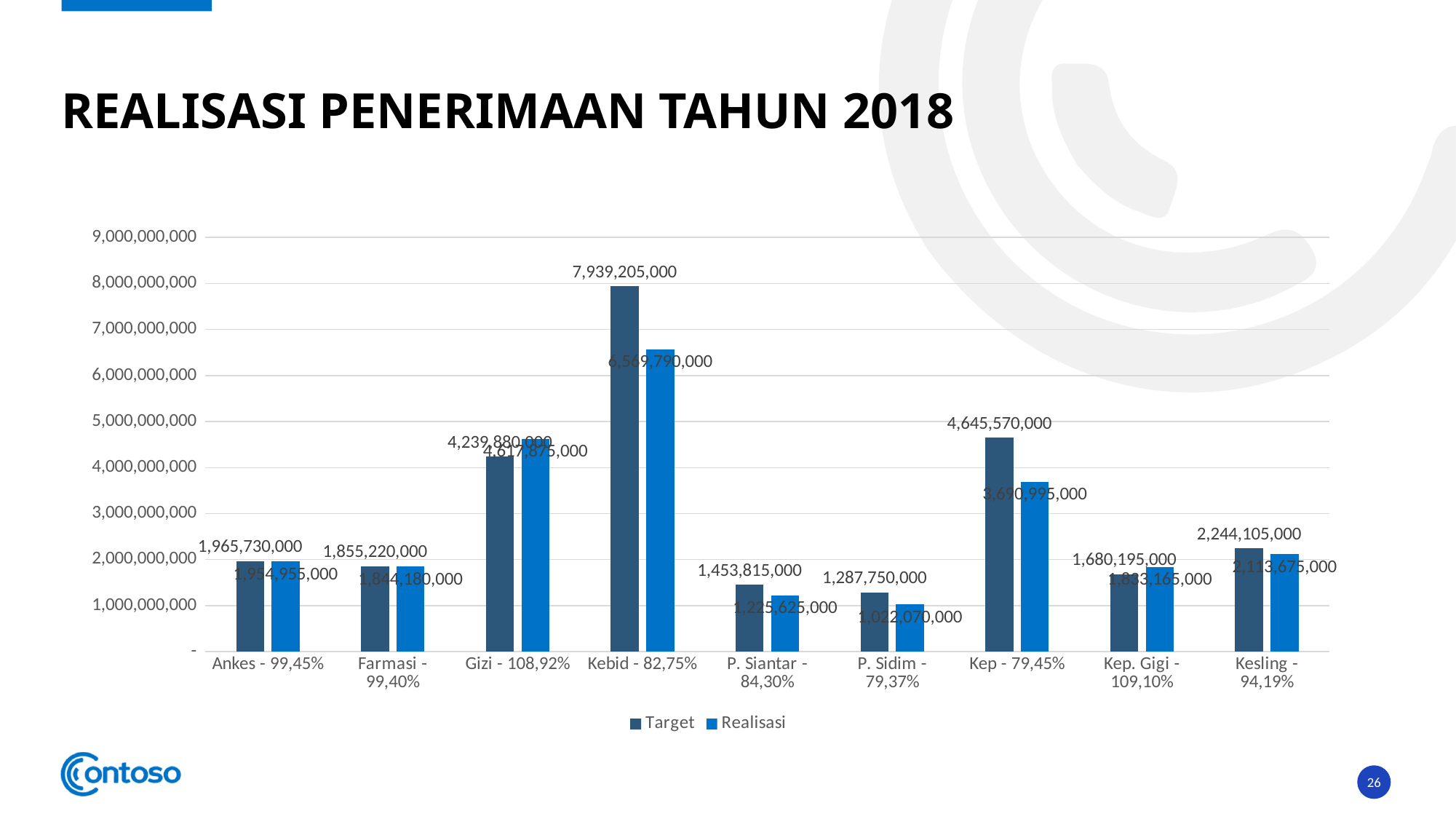
What is the Target value for Kebid - 82,75%? 7,939,205,000 Is the Realisasi value for Kep - 79,45% greater or less than 4,000,000,000? less What are the two series named in the legend? Target and Realisasi What is the Target value for Kep - 79,45%? 4,645,570,000 What kind of chart is shown on the slide? bar chart How many series does the legend list? 2 Which category has the highest Target value? Kebid - 82,75% What is the difference between Target and Realisasi for Kebid - 82,75%? 1,369,415,000 Which category has the lowest Target value? P. Sidim - 79,37% How many categories are shown on the x axis? 9 For Gizi - 108,92%, which is larger, Target or Realisasi? Realisasi What is the Target value for Kesling - 94,19%? 2,244,105,000